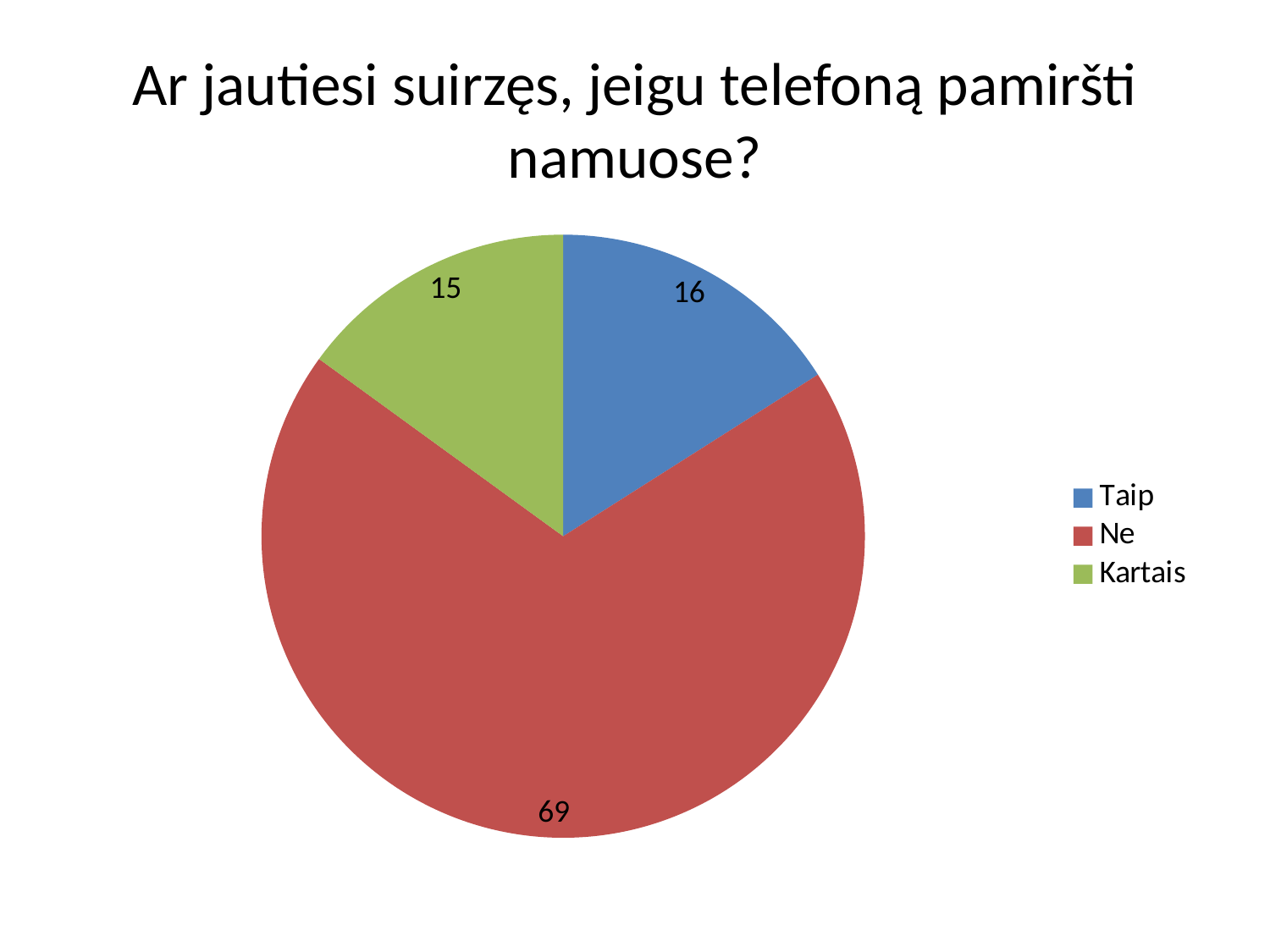
Which is larger, the value for "Ne" or the value for "Kartais"? Ne Which category has the largest slice? Ne What is the total of all the slice values? 100 What value is shown for the "Kartais" slice? 15 What kind of chart is shown on the slide? Pie chart What colour is the "Ne" slice? Red Which category has the smallest slice? Kartais How many slices does the pie chart have? 3 What value is shown for the "Taip" slice? 16 What value is shown for the "Ne" slice? 69 How many entries does the legend list? 3 What is the difference between the values for "Ne" and "Taip"? 53